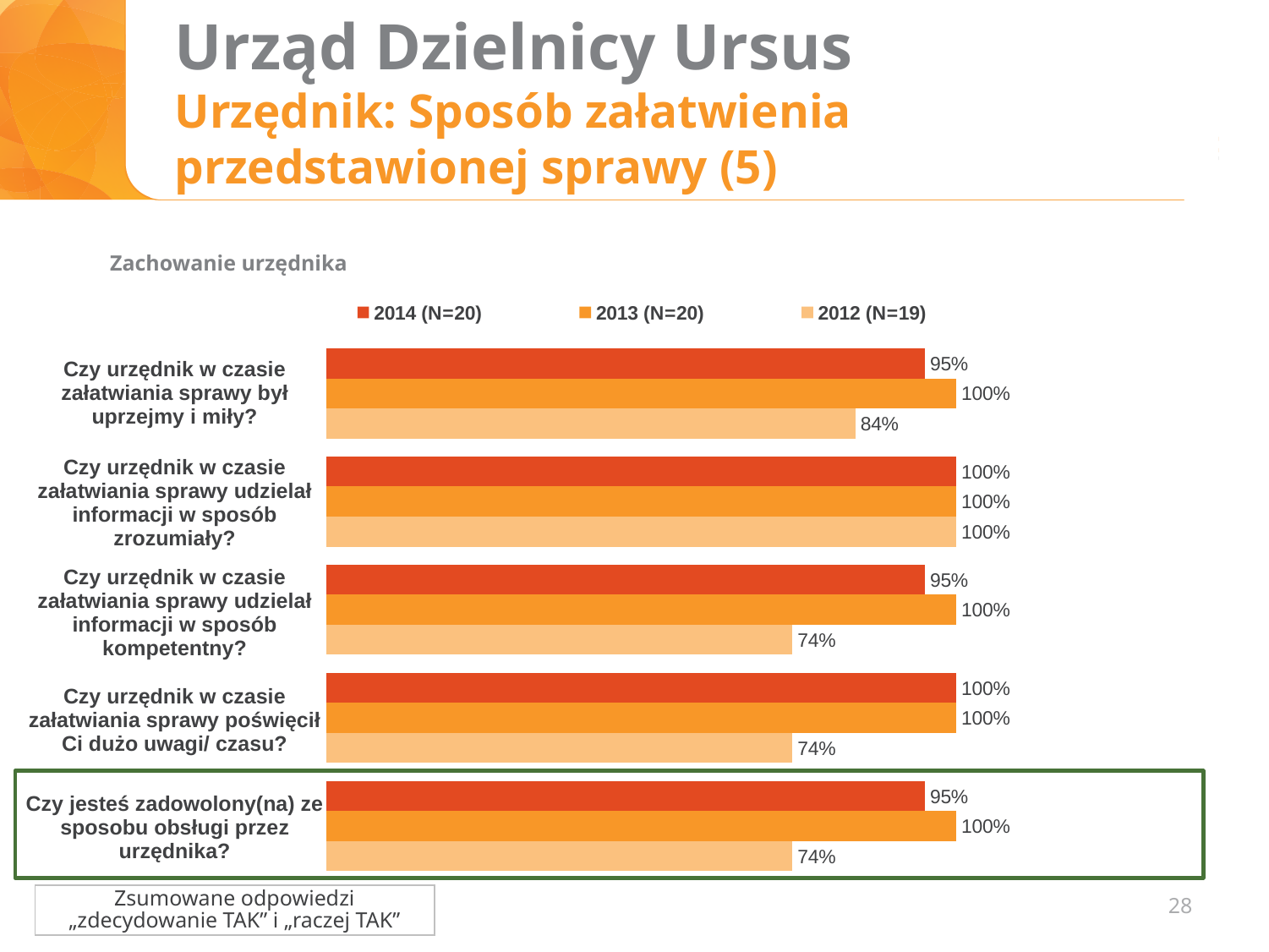
How many series does the legend list? 3 How many question categories are shown on the chart? 5 What kind of chart is shown on the slide? Bar chart What is the difference between the 2013 (N=20) and 2012 (N=19) values for "Czy urzędnik w czasie załatwiania sprawy był uprzejmy i miły?"? 16% For "Czy urzędnik w czasie załatwiania sprawy udzielał informacji w sposób kompetentny?", which is larger: the 2014 (N=20) value or the 2012 (N=19) value? 2014 (N=20) What is the value for 2012 (N=19) for "Czy urzędnik w czasie załatwiania sprawy poświęcił Ci dużo uwagi/ czasu?"? 74% What is the value for 2014 (N=20) for "Czy jesteś zadowolony(na) ze sposobu obsługi przez urzędnika?"? 95% What is the value for 2012 (N=19) for "Czy urzędnik w czasie załatwiania sprawy był uprzejmy i miły?"? 84% What is the value for 2013 (N=20) for "Czy urzędnik w czasie załatwiania sprawy udzielał informacji w sposób kompetentny?"? 100% What is the title shown above the chart? Zachowanie urzędnika What is the difference between the 2014 (N=20) and 2012 (N=19) values for "Czy jesteś zadowolony(na) ze sposobu obsługi przez urzędnika?"? 21%